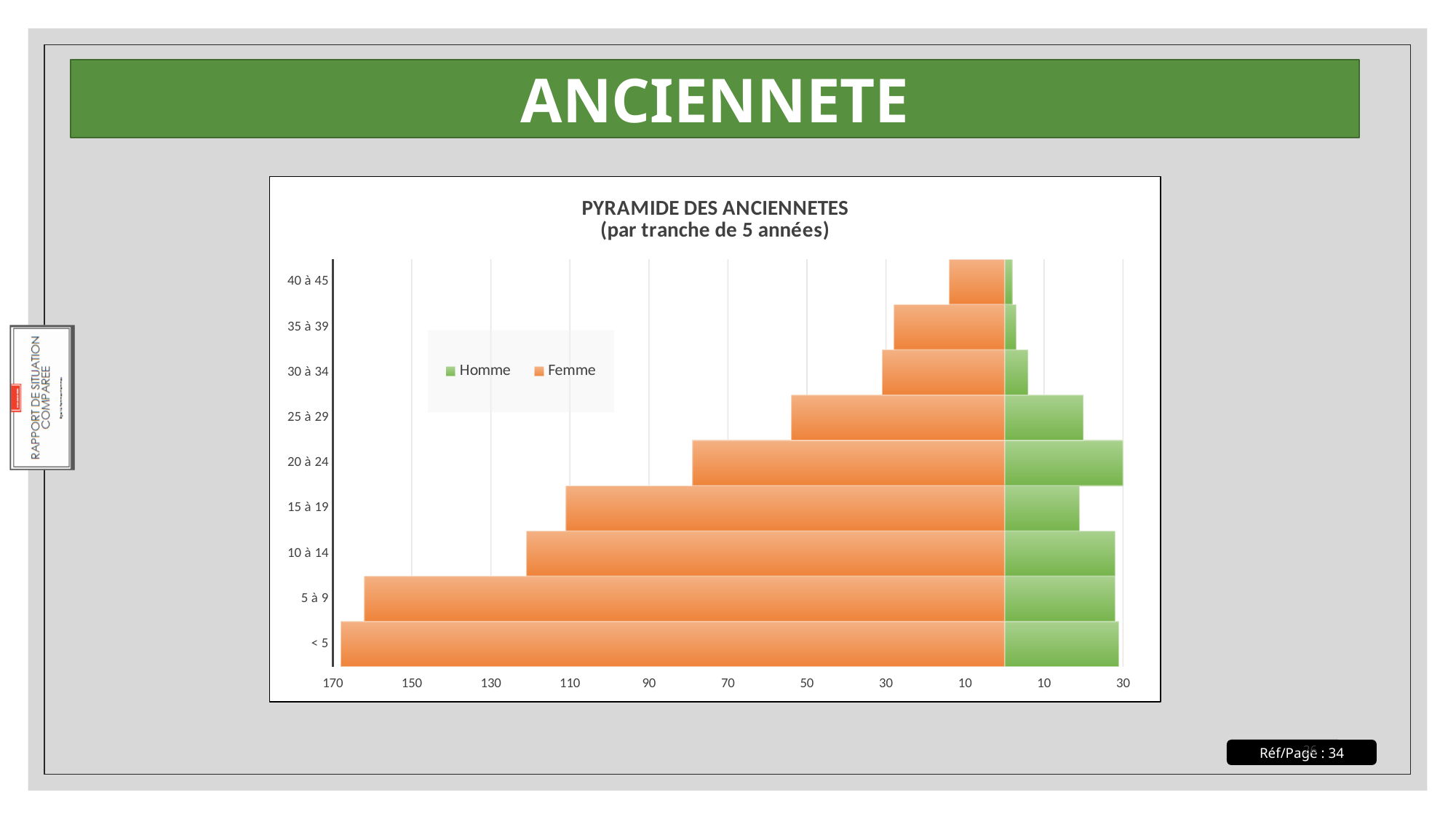
Which is larger, the Femme value for 15 à 19 or for 20 à 24? 15 à 19 Is the Homme value for 40 à 45 greater or less than 10? less Do the Femme values rise or fall as the seniority bracket increases from < 5 to 40 à 45? fall How many seniority categories are shown on the vertical axis? 9 Which category has the lowest Femme value? 40 à 45 What kind of chart is shown on the slide? bar chart Is the Femme value for 10 à 14 greater or less than 110? greater Which category has the highest Femme value? < 5 Is the Femme value for 20 à 24 greater or less than 90? less How many series does the legend list? 2 Which colour represents the Homme series in the legend? green